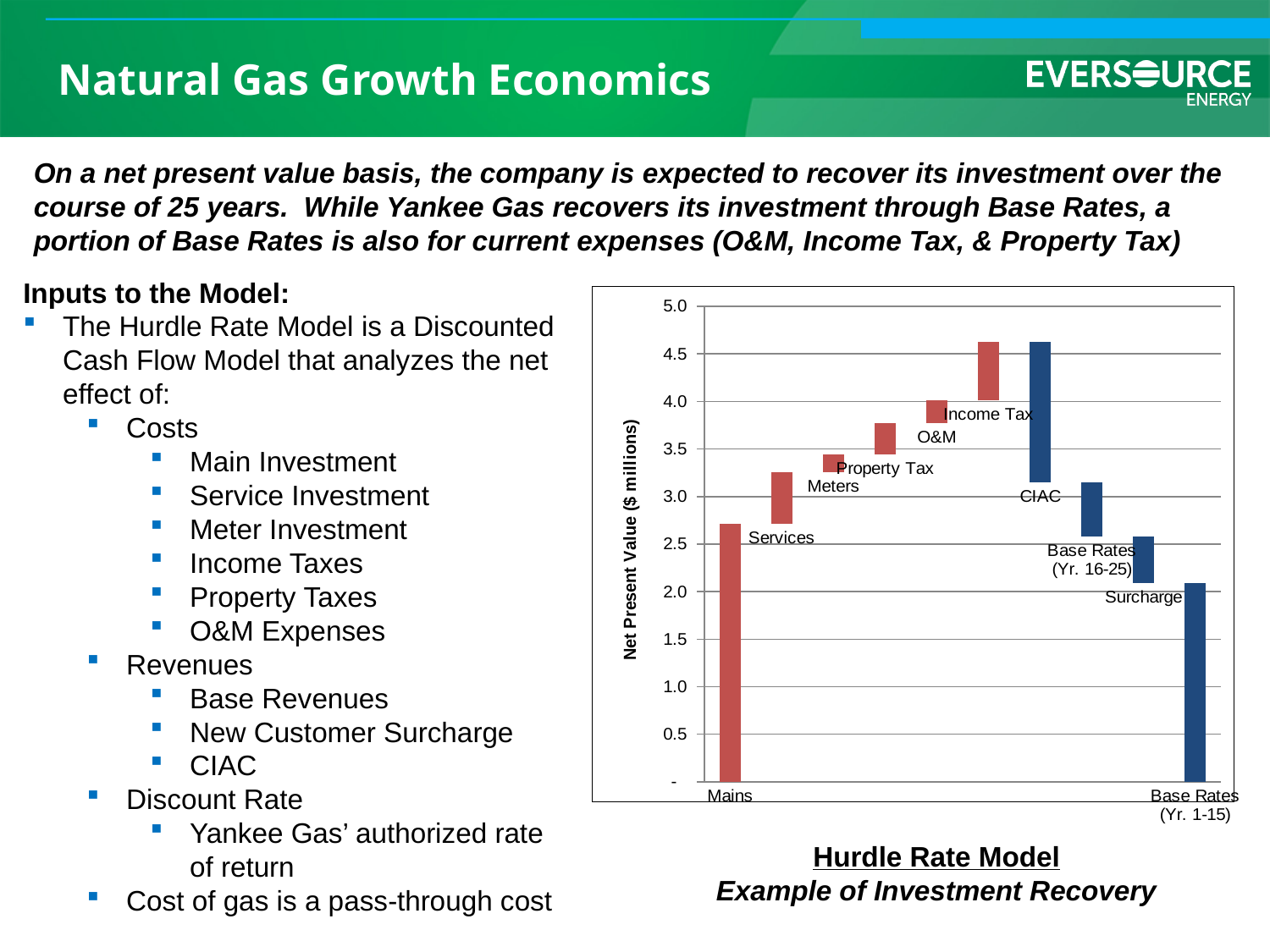
What is the y-axis title of the chart? Net Present Value ($ millions) Which category is the first (leftmost) on the x axis? Mains Is the top of the Services bar greater or less than 3.5? less Is the bottom of the CIAC bar greater or less than 2.5? greater Which bar is longer, Mains or Base Rates (Yr. 1-15)? Mains What kind of chart is shown on the slide? bar chart (waterfall) What is the title printed beneath the chart? Hurdle Rate Model Example of Investment Recovery How many categories are shown along the x axis of the chart? 10 Is the top of the Base Rates (Yr. 1-15) bar greater or less than 2.5? less